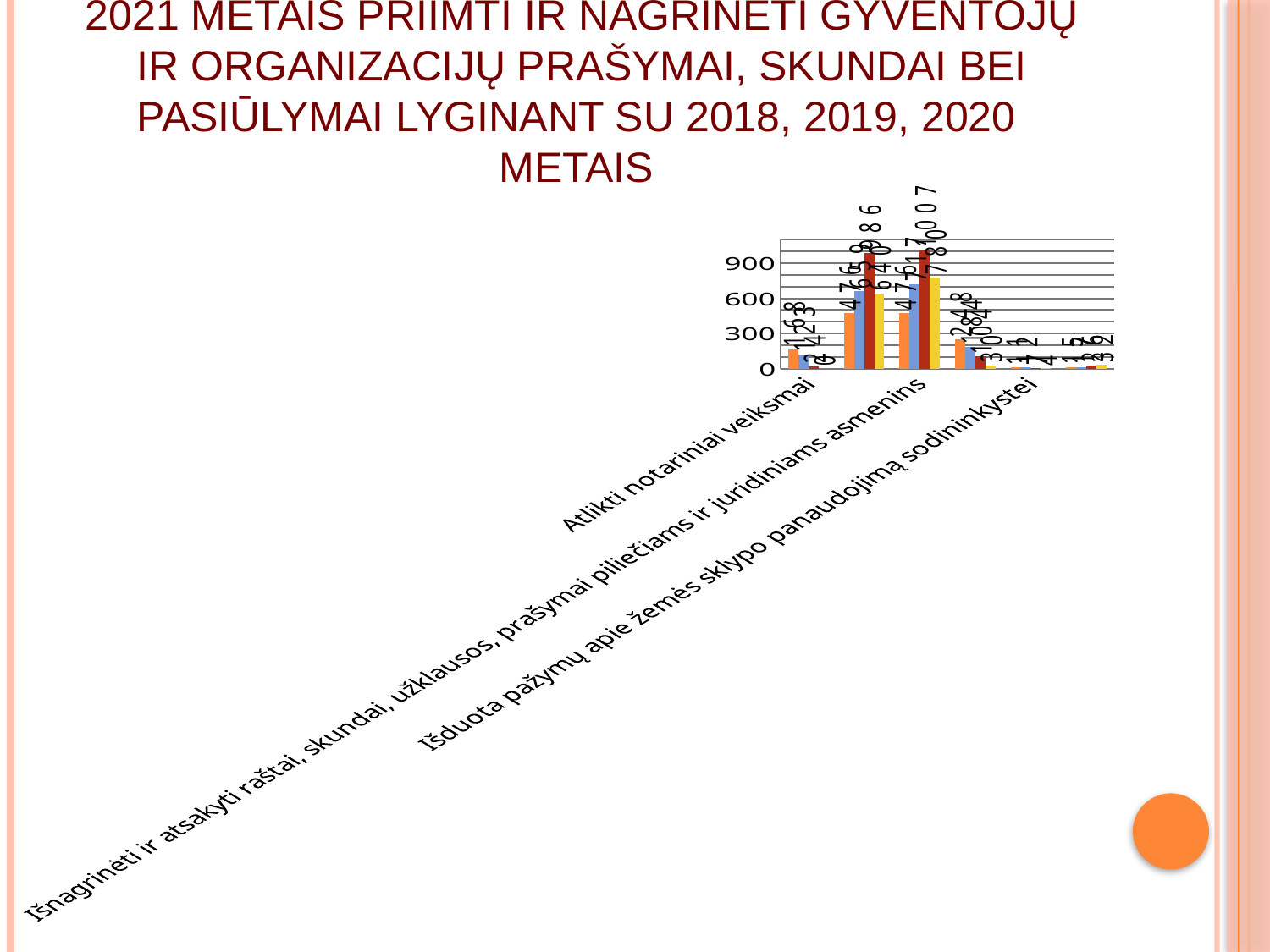
What kind of chart is shown on the slide? bar chart What is the largest data label value shown on any bar in the chart? 1007 What is the highest value labelled on the vertical axis of the chart? 900 How many different bar colours (series) are plotted in each category group of the chart? 4 Is the value of the tallest bar in the chart greater or less than 600? greater Is the tallest bar in the chart greater or less than 900? greater